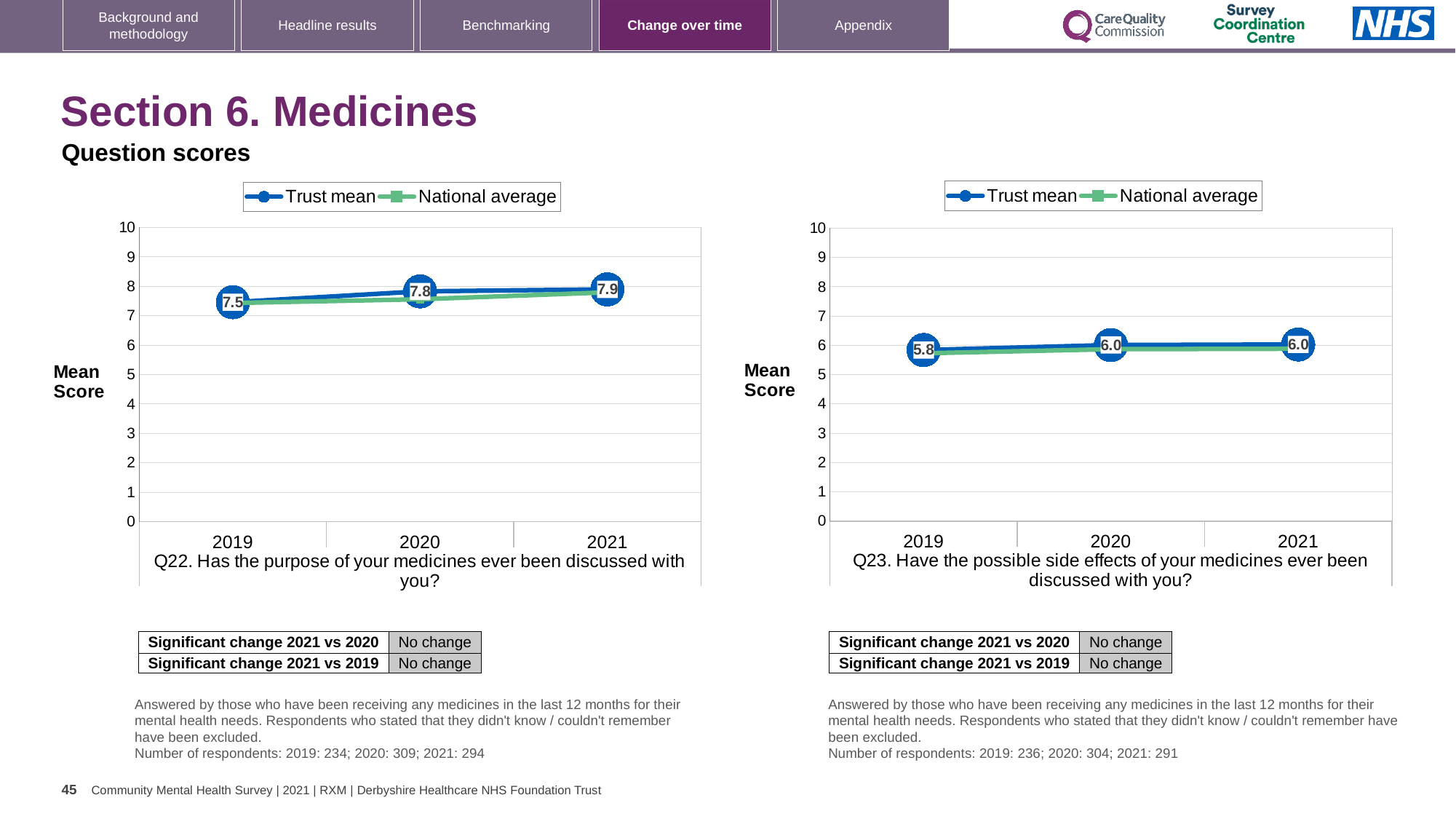
In the Q23 chart on the right, what is the Trust mean score for 2019? 5.8 In the Q23 chart on the right, what is the Trust mean score for 2020? 6.0 In the Q23 chart on the right, which year has the lowest Trust mean score? 2019 In the Q22 chart on the left, is the National average for 2019 greater or less than 8? less In the Q23 chart on the right, which is larger, the Trust mean score for 2019 or for 2021? 2021 How many series does the legend of the Q23 chart on the right list? 2 In the Q22 chart on the left, which year has the highest Trust mean score? 2021 In the Q22 chart on the left, what is the difference between the Trust mean scores for 2021 and 2019? 0.4 In the Q22 chart on the left, does the Trust mean rise or fall from 2019 to 2021? rise How many years are plotted on the x axis of the Q22 chart on the left? 3 In the Q22 chart on the left, what is the Trust mean score for 2021? 7.9 In the Q22 chart on the left, what is the Trust mean score for 2019? 7.5